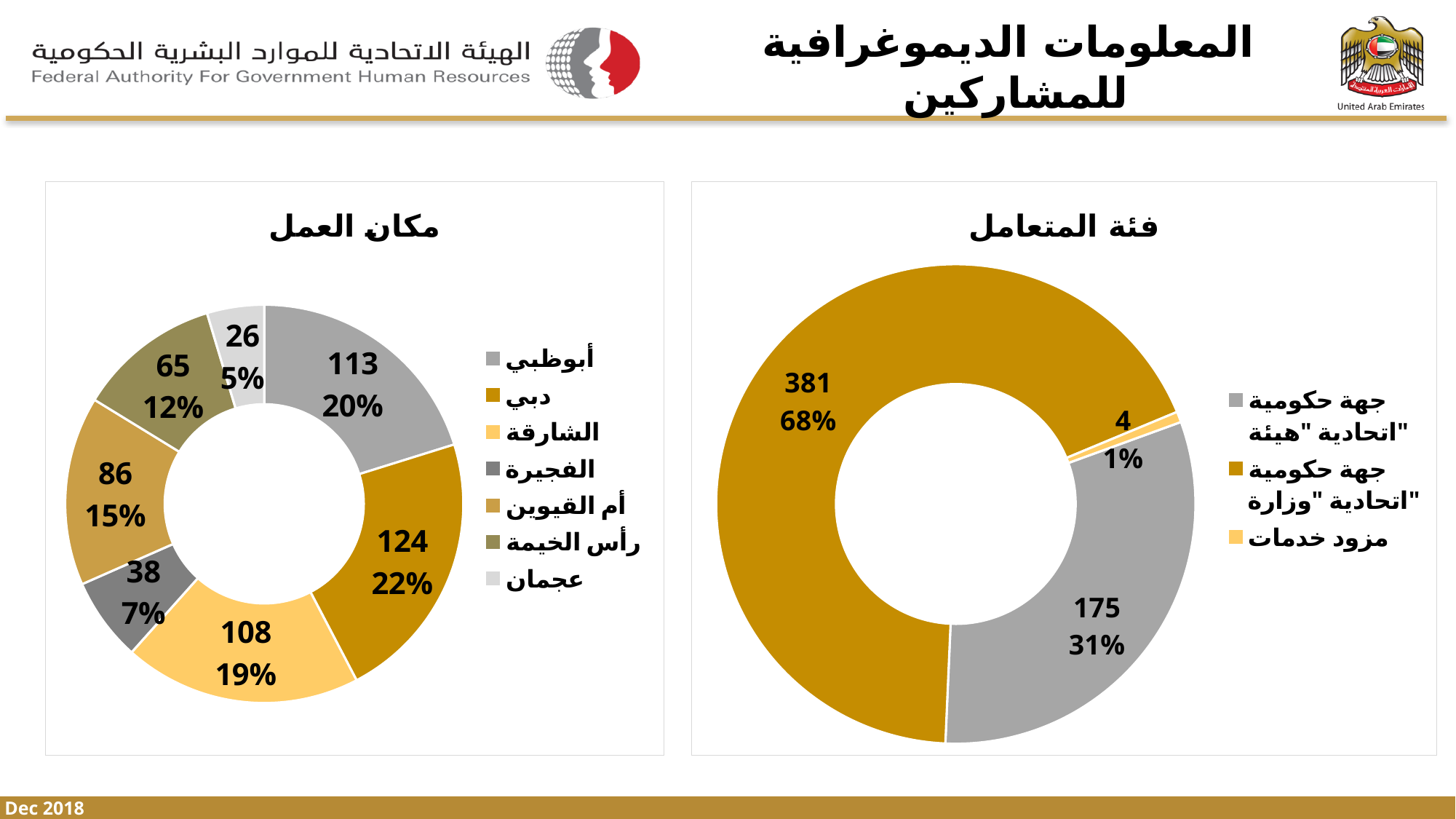
In the chart titled "مكان العمل", what is the difference between the values for أبوظبي and الفجيرة? 75 In the chart titled "فئة المتعامل", how many entries does the legend list? 3 In the chart titled "فئة المتعامل", what is the value for جهة حكومية اتحادية "وزارة"? 381 In the chart titled "مكان العمل", what percentage is shown for الشارقة? 19% In the chart titled "فئة المتعامل", which category has the smallest value? مزود خدمات In the chart titled "مكان العمل", which is larger: the value for أم القيوين or رأس الخيمة? أم القيوين What type of chart is the chart titled "فئة المتعامل"? Doughnut chart In the chart titled "مكان العمل", which category has the highest value? دبي In the chart titled "مكان العمل", which category has the lowest value? عجمان In the chart titled "مكان العمل", what is the value for دبي? 124 In the chart titled "مكان العمل", how many categories are shown? 7 In the chart titled "فئة المتعامل", what percentage share does جهة حكومية اتحادية "هيئة" have? 31%